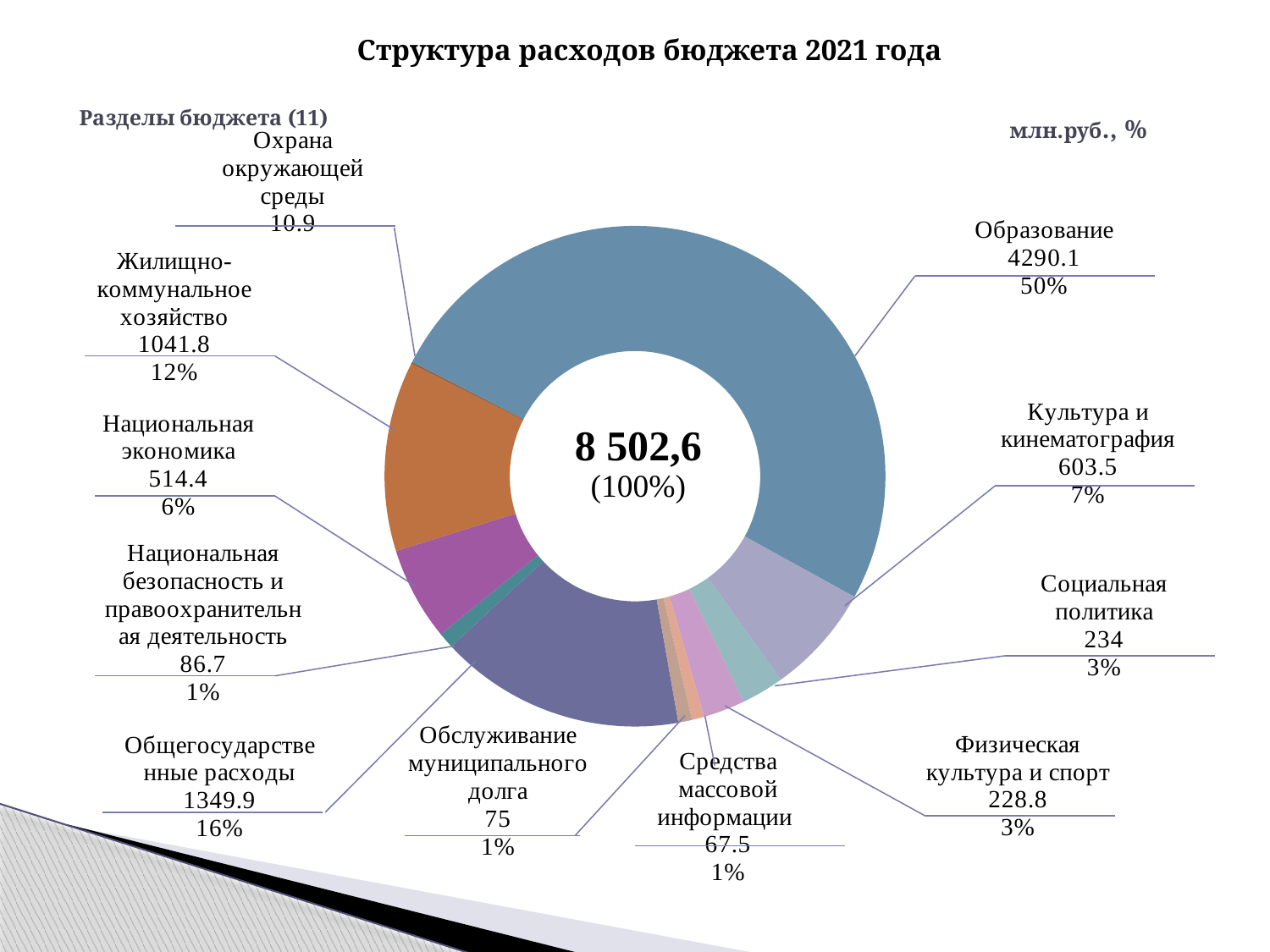
What total value is shown in the centre of the chart? 8 502,6 Which budget section has the smallest value? Охрана окружающей среды What is the value for Жилищно-коммунальное хозяйство? 1041.8 How many budget sections are shown in the chart? 11 What share of the budget does Социальная политика account for? 3% Which is larger, Национальная экономика or Культура и кинематография? Культура и кинематография What kind of chart is shown on the slide? Doughnut chart What is the value for Образование? 4290.1 What is the title of the chart? Разделы бюджета (11) What share of the budget does Общегосударственные расходы account for? 16% What is the difference between the values for Образование and Общегосударственные расходы? 2940.2 Which budget section has the largest share? Образование